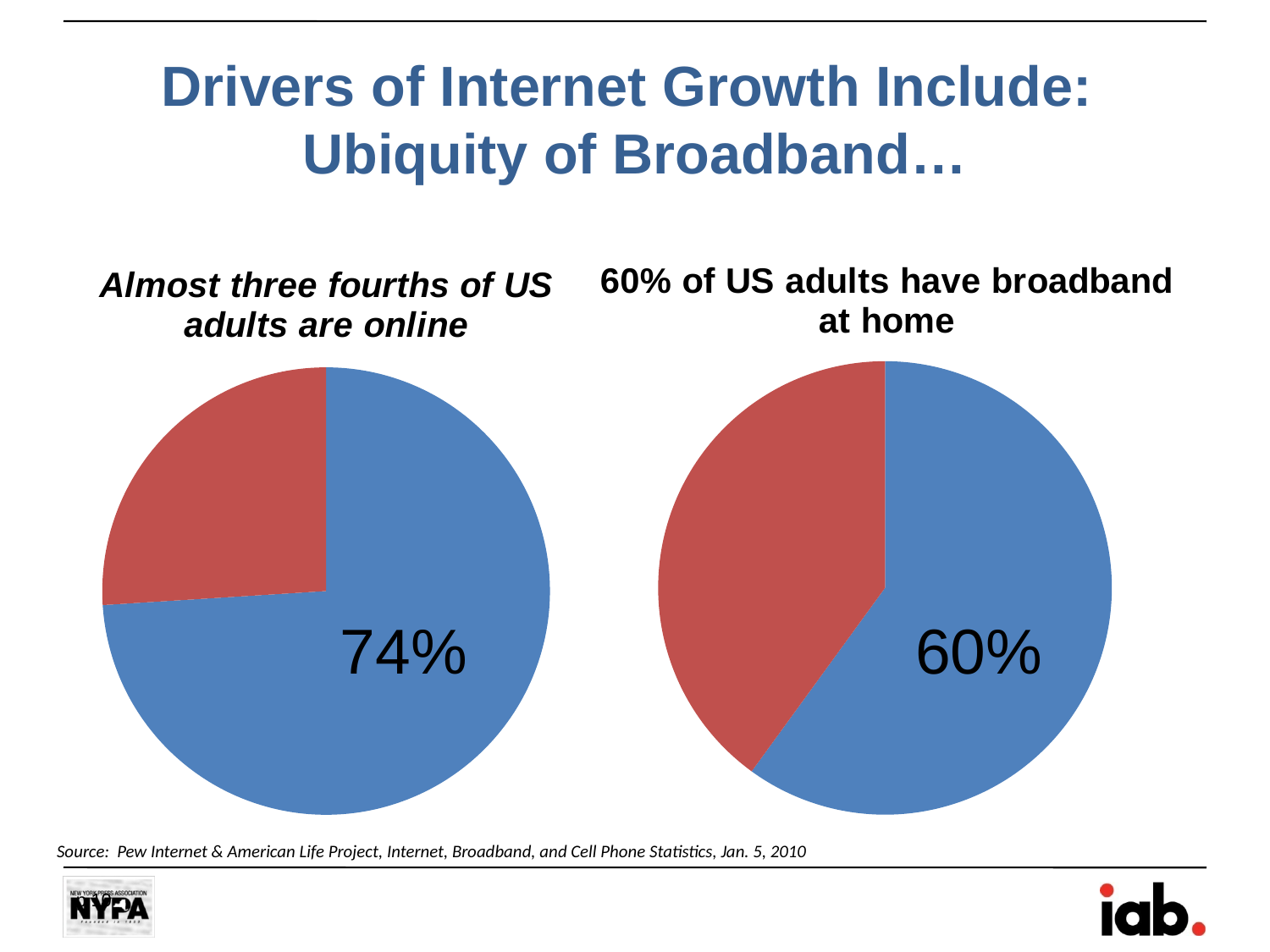
What kind of chart is used on the left side of the slide? Pie chart In the left pie chart, what percentage is shown on the blue slice? 74% What is the heading above the right pie chart? 60% of US adults have broadband at home How many slices does the right pie chart have? 2 What is the difference between the labeled share in the left pie chart and the labeled share in the right pie chart? 14 percentage points How many slices does the left pie chart have? 2 In the right pie chart, is the red slice greater or less than half of the pie? less What kind of chart is used on the right side of the slide? Pie chart In the right pie chart, what percentage is shown on the blue slice? 60% Which is larger: the labeled share in the left pie chart (US adults online) or the labeled share in the right pie chart (US adults with broadband at home)? The left pie chart (74%) What colour is the slice labeled 74% in the left pie chart? Blue In the left pie chart, is the blue slice greater or less than half of the pie? greater